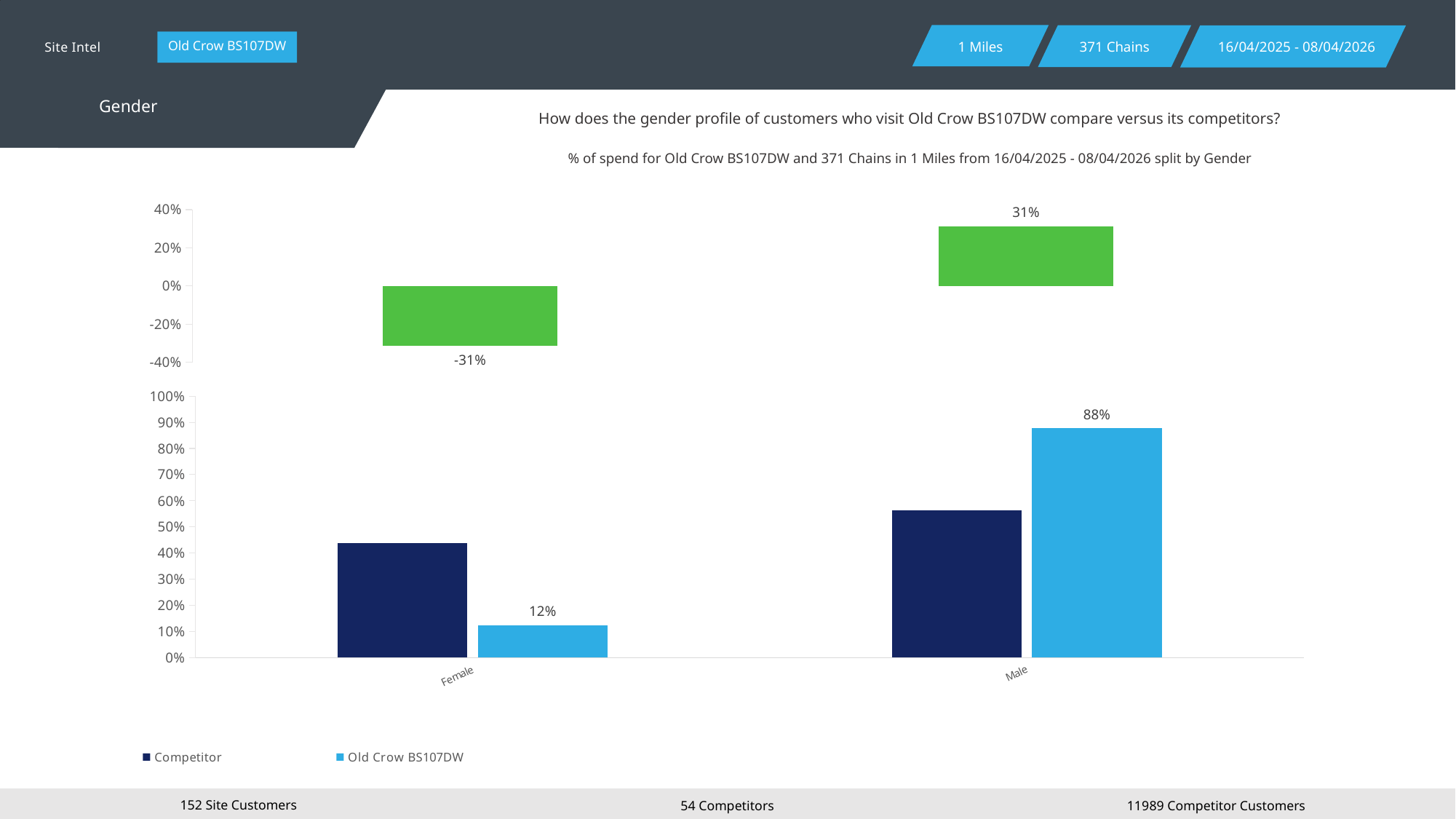
How many categories are shown on the x axis of the bottom chart? 2 How many series does the legend of the bottom chart list? 2 In the bottom chart, for the Male category, which is larger: the Competitor value or the Old Crow BS107DW value? Old Crow BS107DW In the bottom chart, is the Competitor value for Female greater or less than 50%? less In the bottom chart, what is the difference between the Old Crow BS107DW values for Male and Female? 76% In the top chart, what is the value shown for Female? -31% In the top chart, what is the value shown for Male? 31% What kind of chart is the bottom chart? bar chart In the bottom chart, which category has the higher value for Old Crow BS107DW? Male In the bottom chart, what is the value for Old Crow BS107DW in the Female category? 12% In the bottom chart, what is the value for Old Crow BS107DW in the Male category? 88% In the bottom chart, is the Competitor value for Male greater or less than 50%? greater